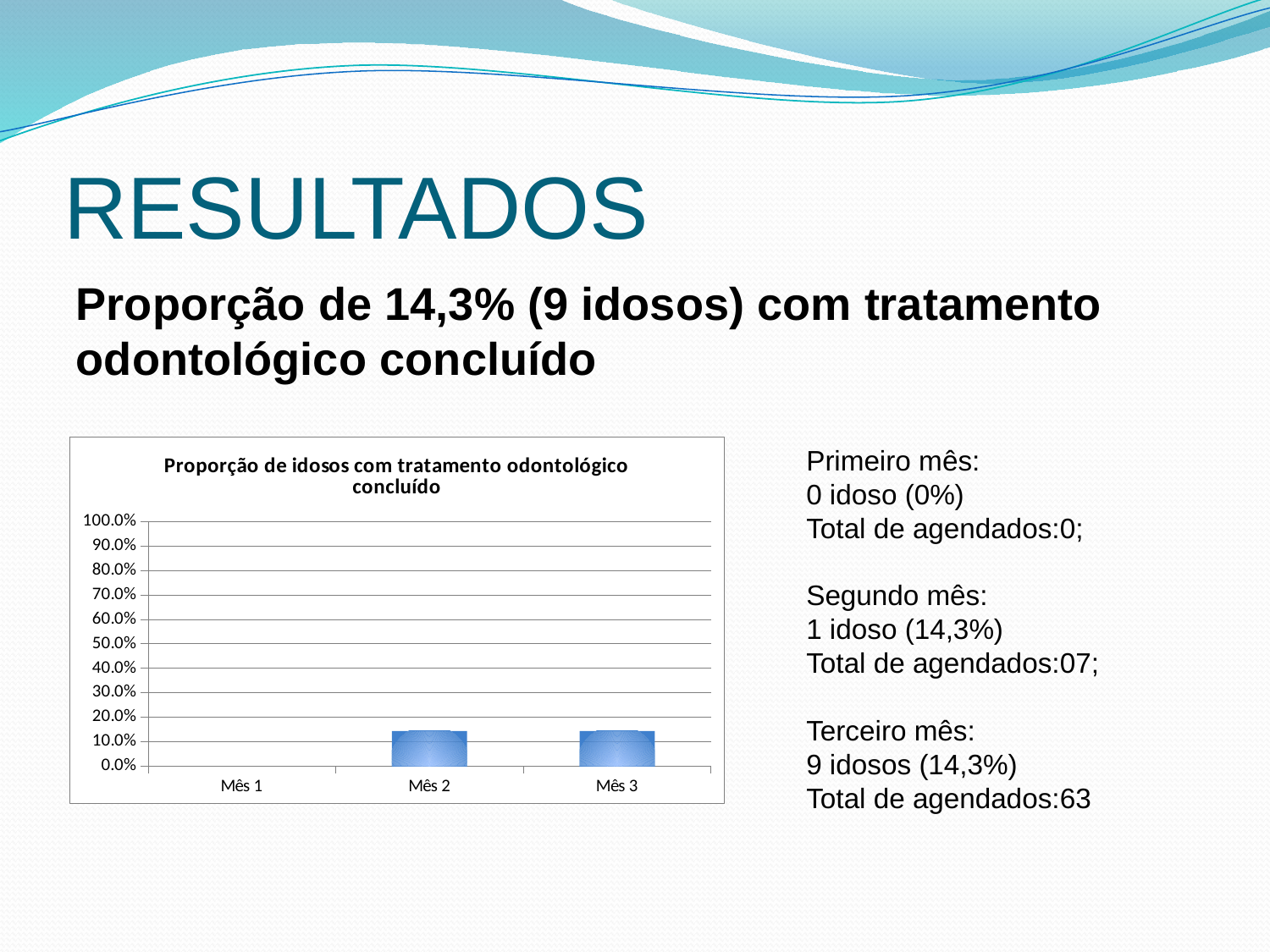
Which has the larger value, Mês 3 or Mês 1? Mês 3 Which has the larger value, Mês 1 or Mês 2? Mês 2 Which category has the lowest value in the chart? Mês 1 What is the value for Mês 1 in the chart? 0.0% What is the highest tick value shown on the y axis of the chart? 100.0% What is the title of the chart? Proporção de idosos com tratamento odontológico concluído Does the value rise or fall from Mês 1 to Mês 2? rise What kind of chart is shown on the slide? bar chart How many categories are shown on the x axis of the chart? 3 Is the value for Mês 3 greater or less than 10.0%? greater Is the value for Mês 2 greater or less than 20.0%? less Is the value for Mês 2 greater or less than 50.0%? less